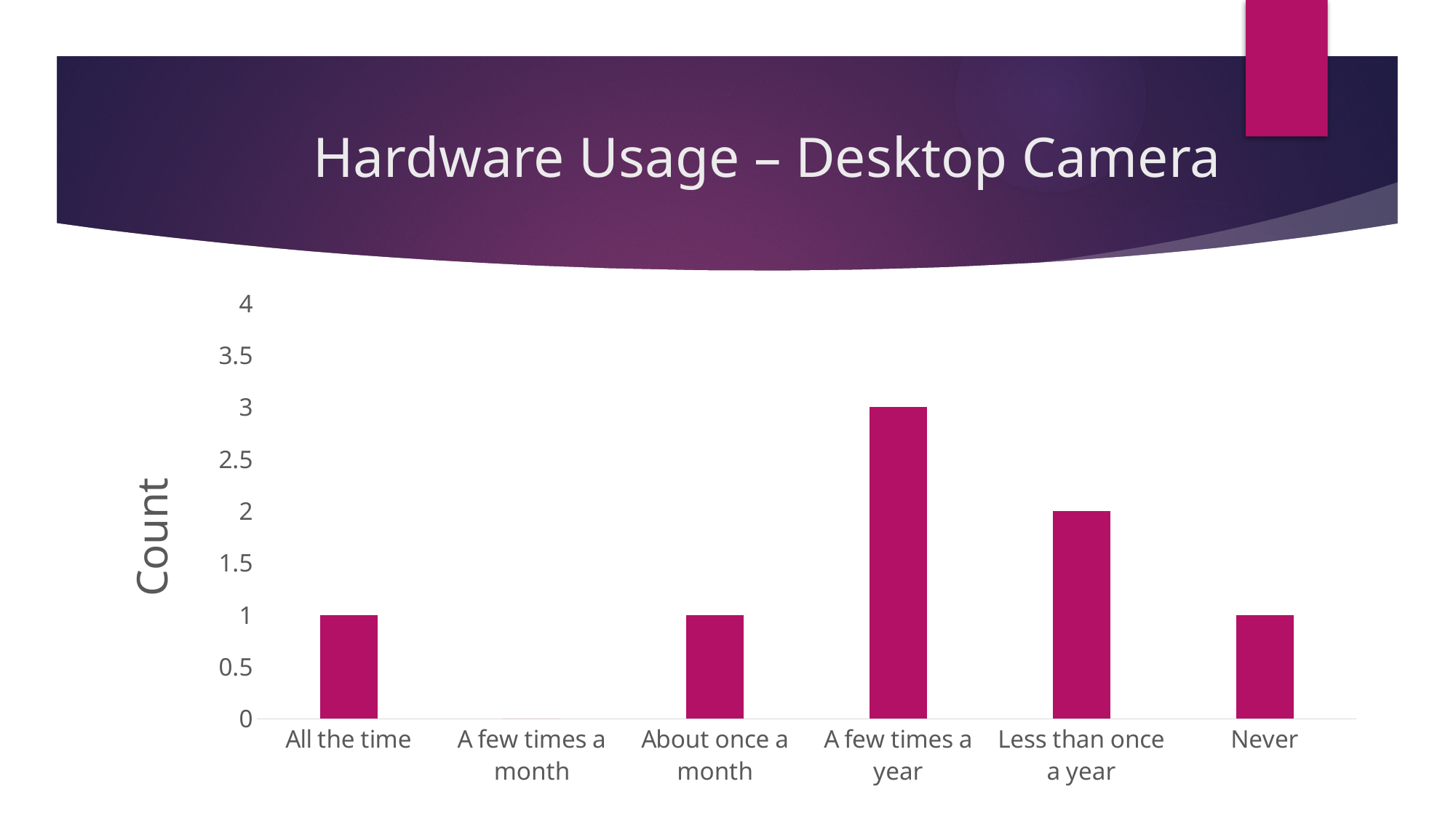
Which category has the highest count? A few times a year What is the count for "Never"? 1 What kind of chart is shown on the slide? Bar chart How many categories are shown on the x axis? 6 What is the count for "A few times a month"? 0 What is the count for "A few times a year"? 3 Which category has the lowest count? A few times a month Is the count for "A few times a year" greater or less than 2? greater What is the difference between the counts for "A few times a year" and "Less than once a year"? 1 What is the label of the vertical axis? Count What is the count for "Less than once a year"? 2 Which has a larger count, "All the time" or "Less than once a year"? Less than once a year